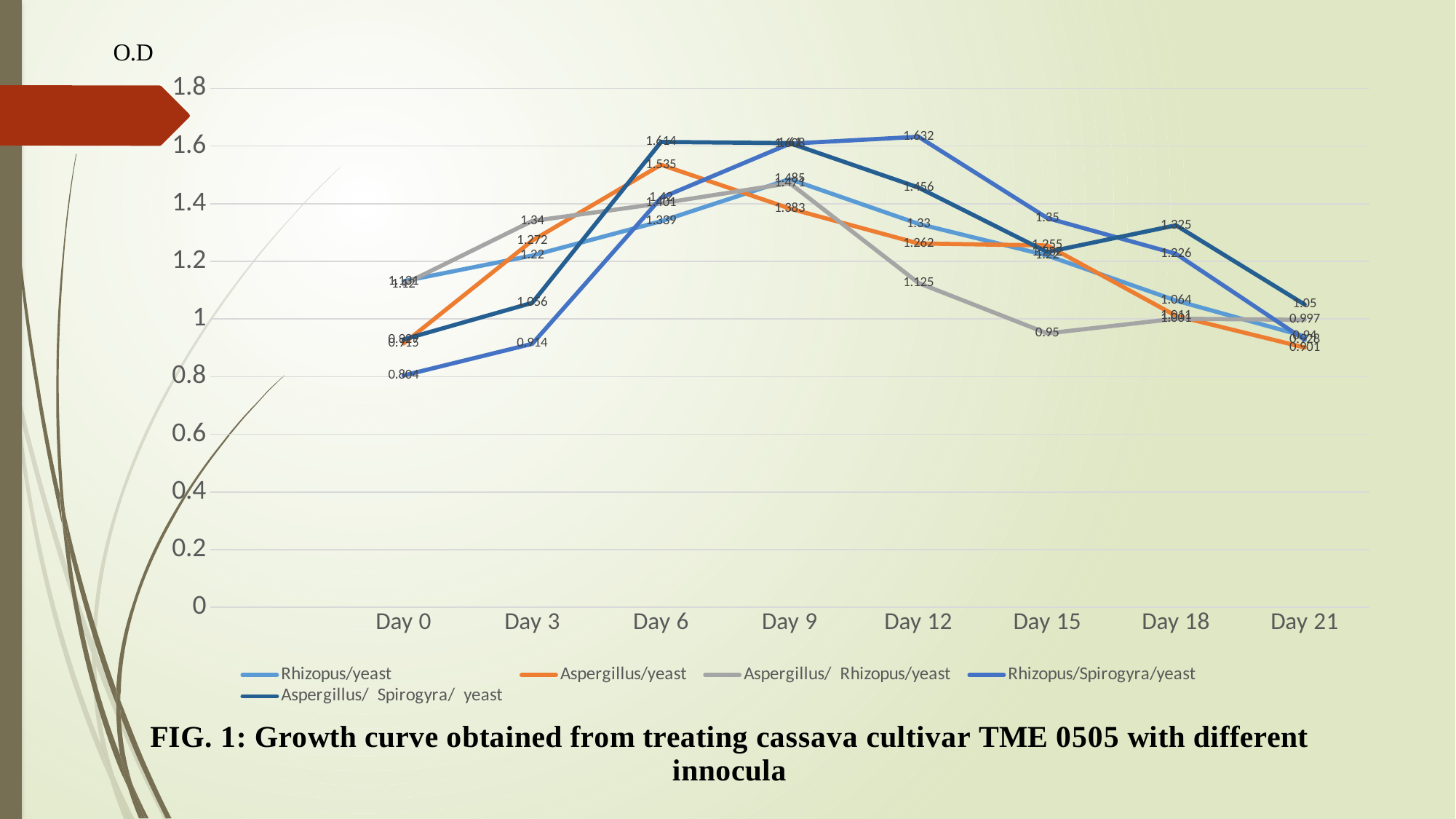
How many time points (days) are plotted along the x axis? 8 What is the O.D value for Rhizopus/Spirogyra/yeast at Day 0? 0.804 Which series has the highest O.D value at Day 12? Rhizopus/Spirogyra/yeast At Day 15, which is larger: Aspergillus/Spirogyra/yeast or Aspergillus/Rhizopus/yeast? Aspergillus/Spirogyra/yeast How many series does the legend list? 5 What is the difference between the Day 6 values of Aspergillus/Spirogyra/yeast (1.614) and Aspergillus/yeast (1.535)? 0.079 What is the O.D value for Aspergillus/Spirogyra/yeast at Day 6? 1.614 What kind of chart is shown on the slide? line chart What is the O.D value for Rhizopus/Spirogyra/yeast at Day 12? 1.632 What is the O.D value for Aspergillus/Rhizopus/yeast at Day 12? 1.125 Which series has the lowest O.D value at Day 0? Rhizopus/Spirogyra/yeast Is the value for Aspergillus/Rhizopus/yeast at Day 15 greater or less than 1? less